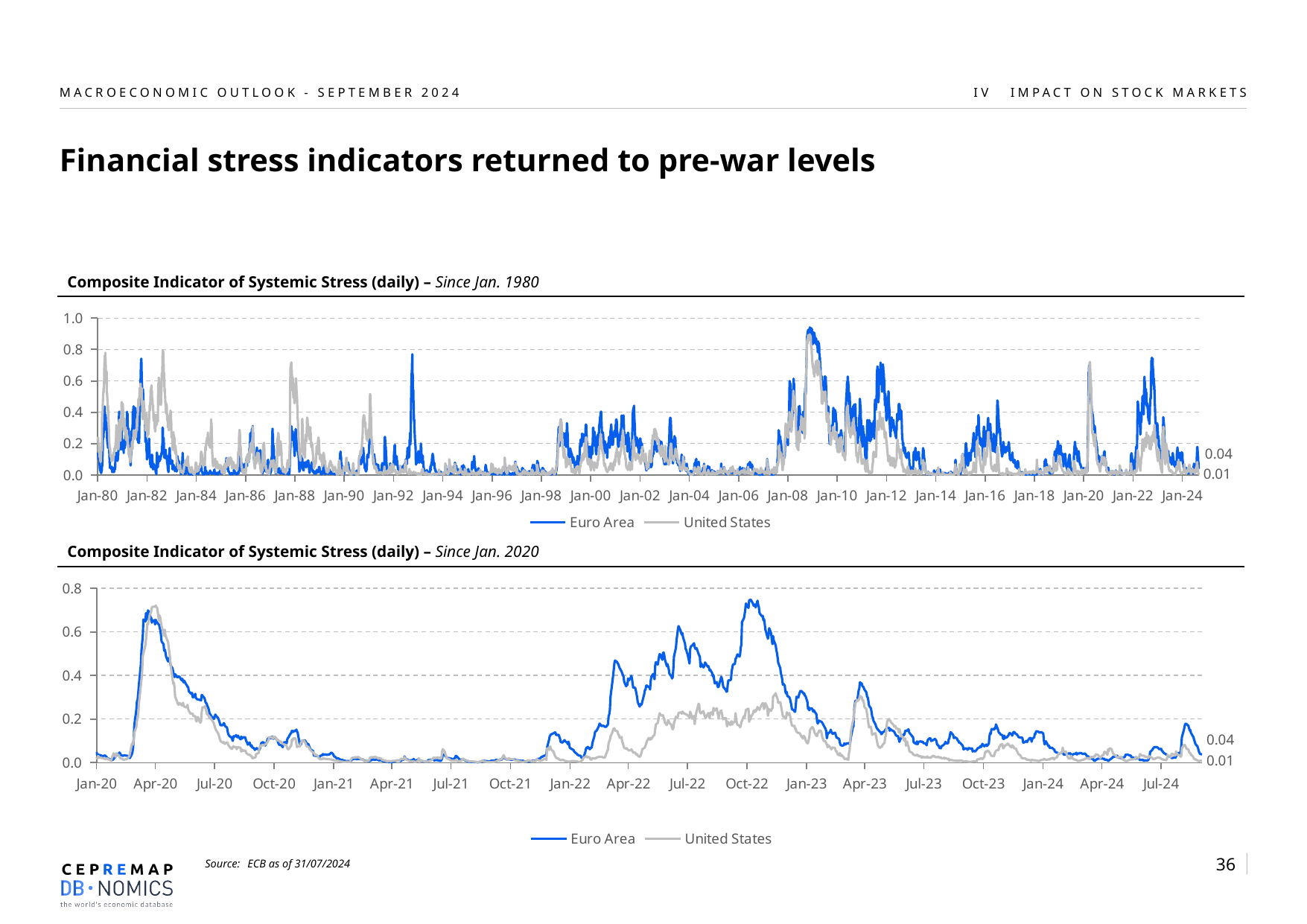
In the chart 'Since Jan. 1980', what is the latest value shown for the Euro Area? 0.04 In the chart 'Since Jan. 2020', which series has the higher latest value, Euro Area or United States? Euro Area In the chart 'Since Jan. 2020', is the United States peak around Apr-20 greater or less than 0.6? greater In the chart 'Since Jan. 2020', is the Euro Area peak around Oct-22 greater or less than 0.6? greater In the chart 'Since Jan. 1980', around which period does the Euro Area series reach its highest value? Around 2008-2009 In the chart 'Since Jan. 2020', what is the difference between the latest Euro Area value and the latest United States value? 0.03 Which colour represents the United States in the charts? Grey In the chart 'Since Jan. 2020', does the Euro Area series rise or fall from Oct-22 to Jan-24? Fall What kind of chart is the chart 'Since Jan. 2020'? Line chart How many series does the legend of the chart 'Since Jan. 1980' list? 2 In the chart 'Since Jan. 1980', what is the latest value shown for the United States? 0.01 In the chart 'Since Jan. 2020', is the United States value around Oct-22 greater or less than 0.4? less